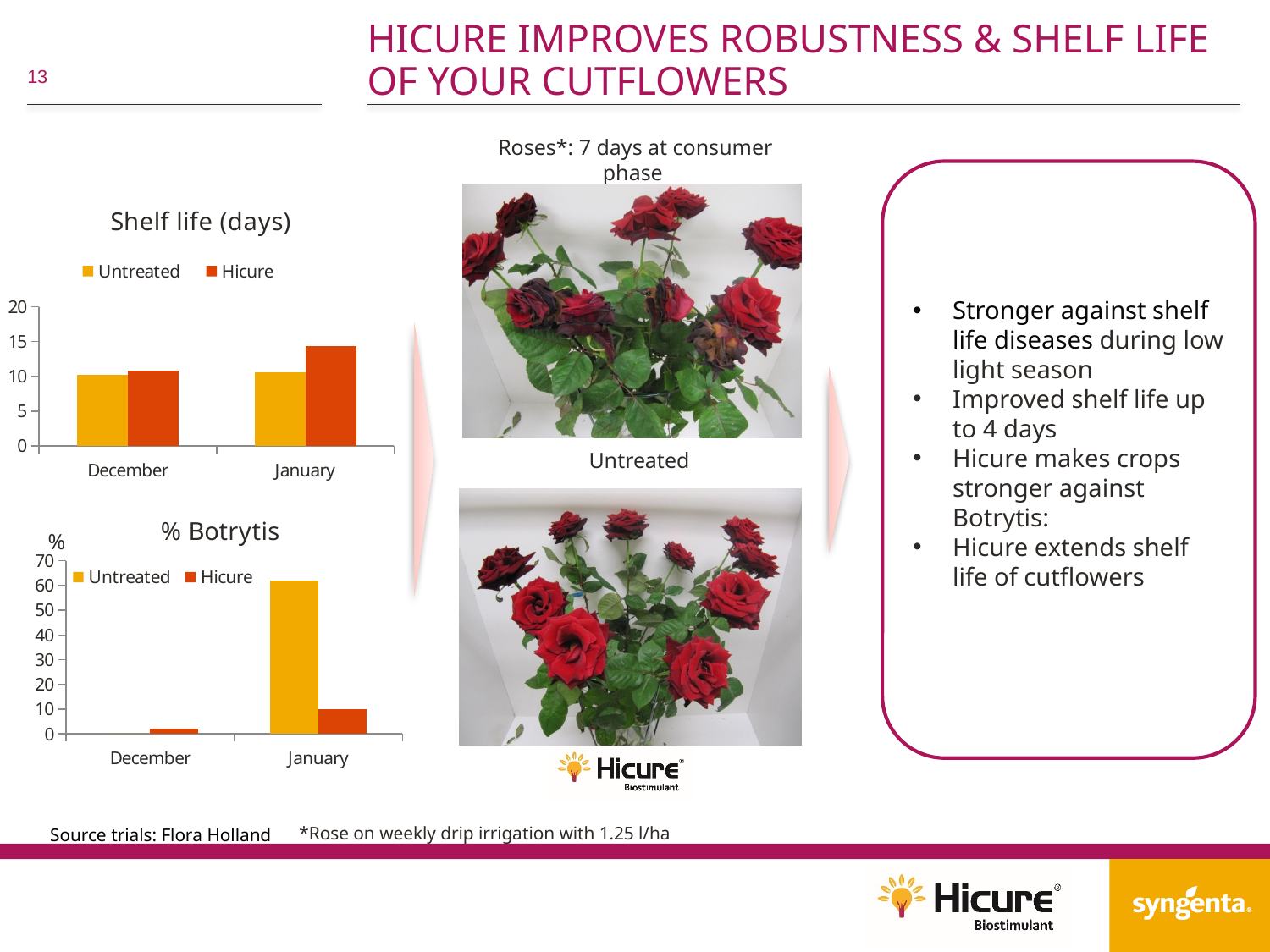
In the "% Botrytis" chart, is the value for Untreated in January greater or less than 50? greater How many series does the legend of the "% Botrytis" chart list? 2 In the "% Botrytis" chart, is the value for Hicure in January greater or less than 20? less In the "Shelf life (days)" chart, which category and series has the highest bar? January, Hicure In the "Shelf life (days)" chart, is the value for Hicure in January greater or less than 15? less In the "Shelf life (days)" chart, which is larger in January: Untreated or Hicure? Hicure In the "% Botrytis" chart, does the Untreated series rise or fall from December to January? rise How many categories are shown on the x axis of the "Shelf life (days)" chart? 2 What are the two legend entries in the "Shelf life (days)" chart? Untreated and Hicure What kind of chart is the "Shelf life (days)" chart? bar chart In the "% Botrytis" chart, which category and series has the highest bar? January, Untreated